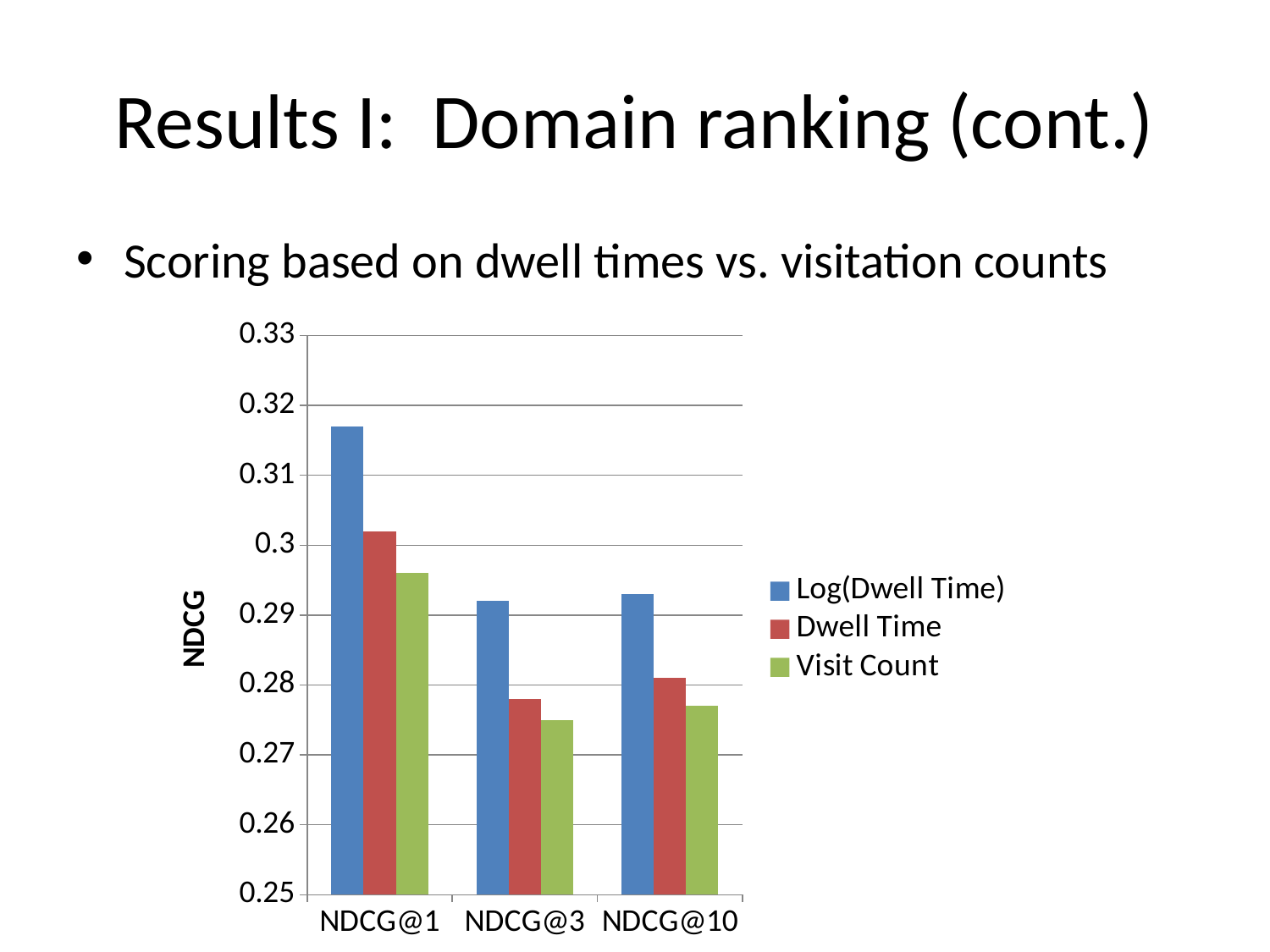
Which is larger at NDCG@10: the Log(Dwell Time) value or the Visit Count value? Log(Dwell Time) Which series has the lowest bar at NDCG@3? Visit Count Is the Visit Count value for NDCG@1 greater or less than 0.3? less What kind of chart is shown on the slide? bar chart Which series has the highest bar at NDCG@1? Log(Dwell Time) Which category has the highest Log(Dwell Time) value? NDCG@1 How many series does the legend list? 3 Which is larger for Dwell Time: the value at NDCG@1 or the value at NDCG@3? NDCG@1 What is the title of the vertical axis? NDCG How many categories are shown on the x axis? 3 Is the Visit Count value for NDCG@3 greater or less than 0.28? less Is the Log(Dwell Time) value for NDCG@1 greater or less than 0.31? greater